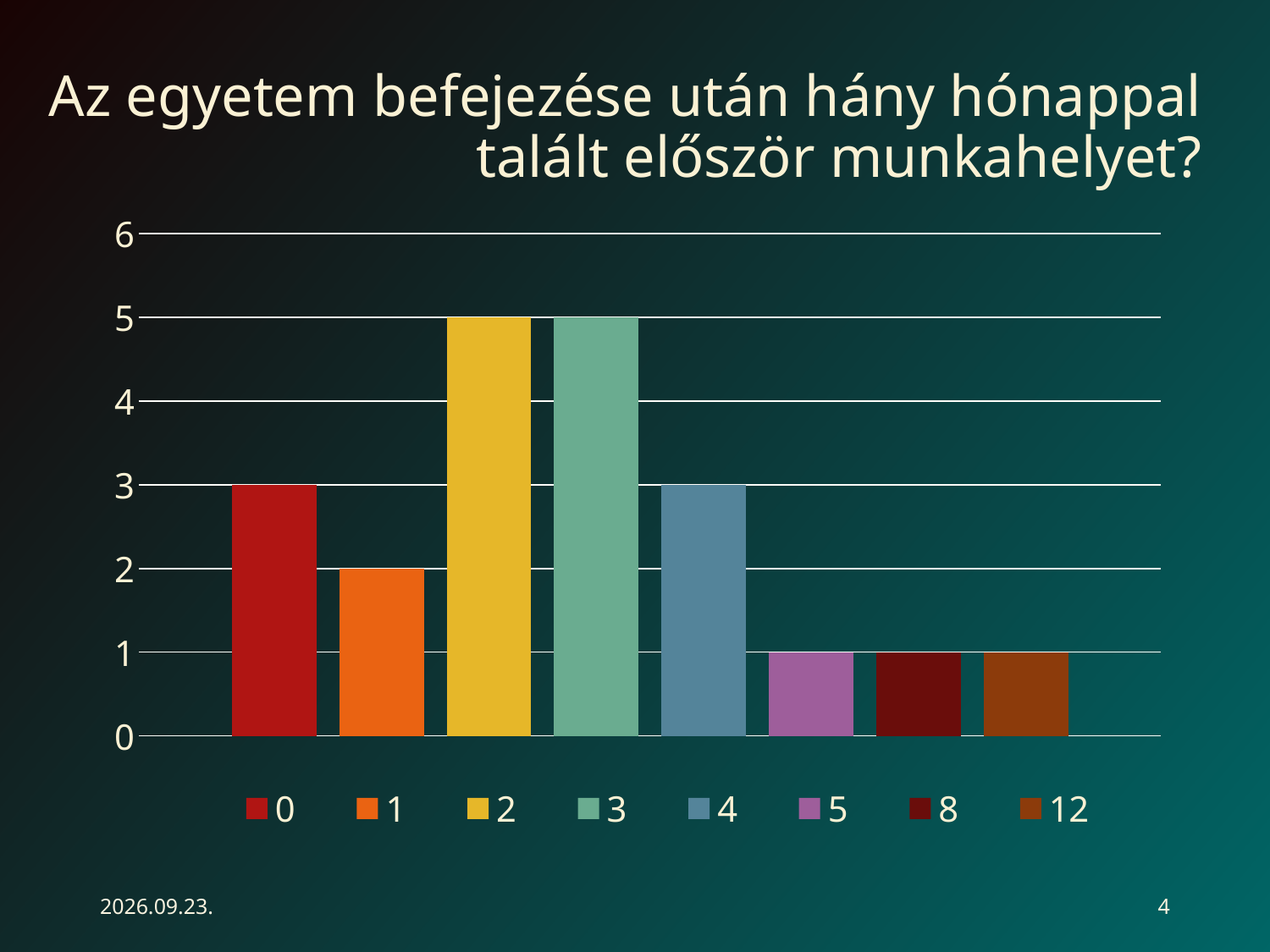
Is the value for category 4 greater or less than 2? greater What is the value of the bar for category 2? 5 How many bars are plotted in the chart? 8 What is the highest value reached by any bar in the chart? 5 What kind of chart is shown on the slide? bar chart What is the title of the chart? Az egyetem befejezése után hány hónappal talált először munkahelyet? What is the value of the bar for category 12? 1 What is the value of the bar for category 1? 2 What is the difference between the values for category 2 and category 1? 3 What is the value of the bar for category 4? 3 Which has the larger value, category 0 or category 1? 0 What is the value of the bar for category 0? 3